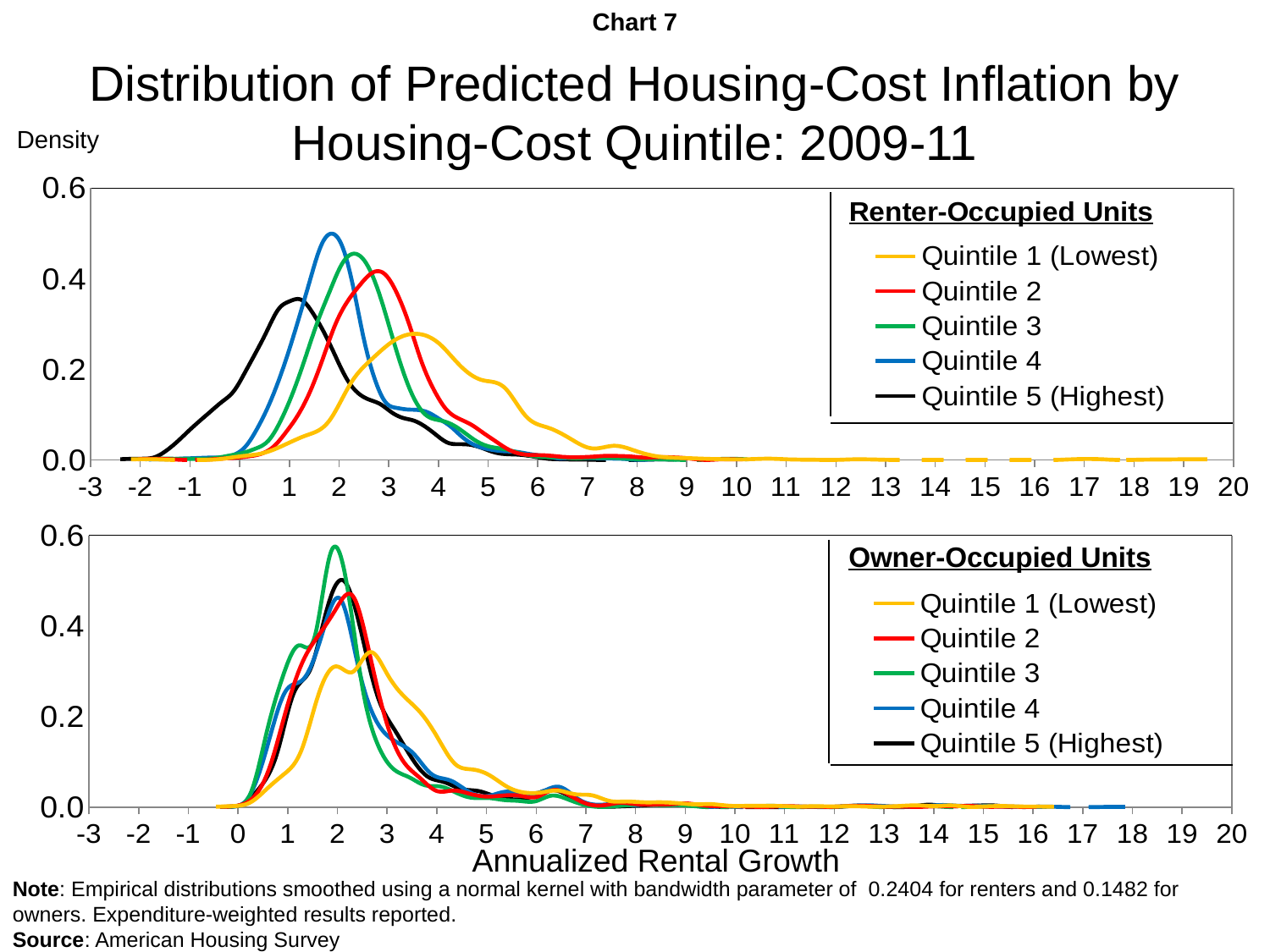
In the Owner-Occupied Units chart, which quintile's curve reaches the highest peak density? Quintile 3 What kind of chart is the Renter-Occupied Units chart? line chart How many series does the legend of the Owner-Occupied Units chart list? 5 In the Renter-Occupied Units chart, which quintile's curve has the lowest peak density? Quintile 1 (Lowest) What source is cited for the charts? American Housing Survey In the Owner-Occupied Units chart, is the peak density of Quintile 3 greater or less than 0.4? greater In the Renter-Occupied Units chart, which has the higher peak density, Quintile 5 (Highest) or Quintile 4? Quintile 4 In the Owner-Occupied Units chart, which quintile's curve has the lowest peak density? Quintile 1 (Lowest) In the Renter-Occupied Units chart, which quintile's curve reaches the highest peak density? Quintile 4 What is the label on the x axis shared by the two charts? Annualized Rental Growth In the Renter-Occupied Units chart, is the peak density of Quintile 4 greater or less than 0.4? greater In the Renter-Occupied Units chart, is the peak density of Quintile 1 (Lowest) greater or less than 0.4? less